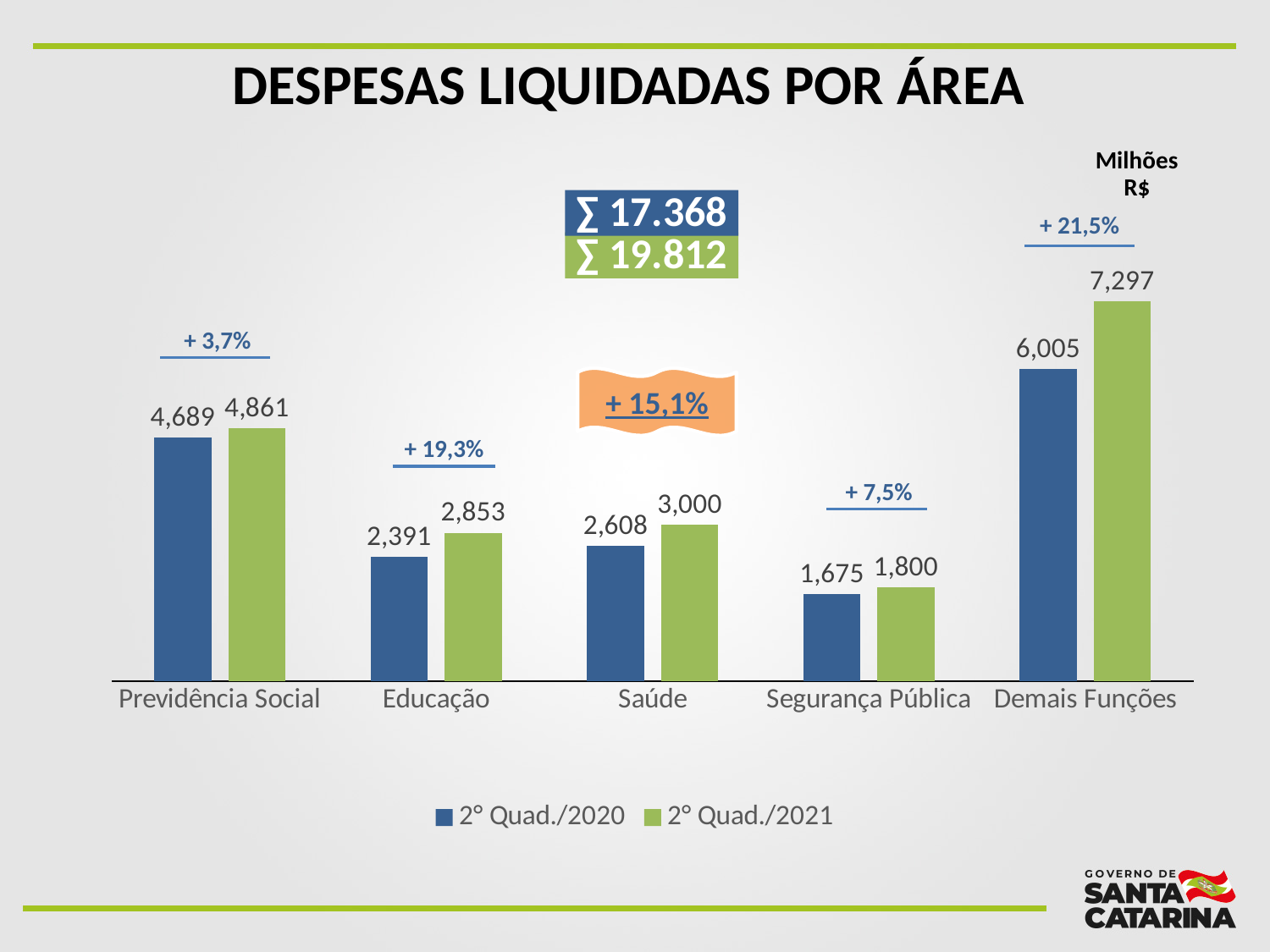
What is the value for Educação in the 2° Quad./2020 series? 2,391 How many series does the legend list? 2 Which category has the highest value in the 2° Quad./2021 series? Demais Funções How many categories are shown on the x axis? 5 What is the value for Segurança Pública in the 2° Quad./2021 series? 1,800 Which is larger: the 2° Quad./2020 value for Previdência Social or the 2° Quad./2021 value for Saúde? 2° Quad./2020 value for Previdência Social What percentage change is shown above the Educação bars? + 19,3% What is the value for Saúde in the 2° Quad./2021 series? 3,000 What is the title of the chart? DESPESAS LIQUIDADAS POR ÁREA What kind of chart is shown on the slide? Bar chart Which category has the lowest value in the 2° Quad./2020 series? Segurança Pública What is the difference between the 2° Quad./2021 and 2° Quad./2020 values for Demais Funções? 1,292